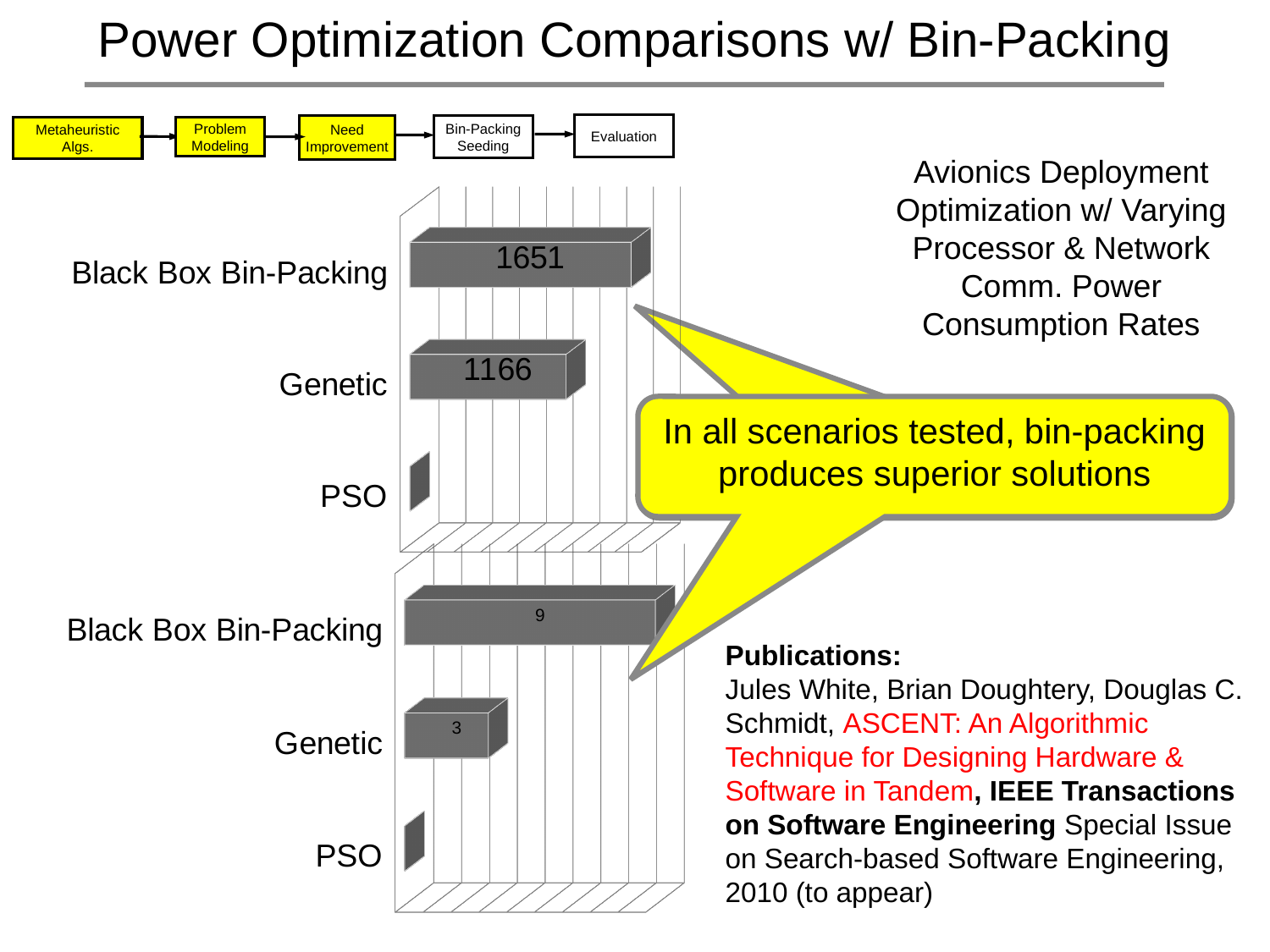
In the top chart, what is the difference between the Black Box Bin-Packing and Genetic values? 485 What kind of chart is the bottom chart? Bar chart In the bottom chart, what is the value for Genetic? 3 In the top chart, which category has the lowest value? PSO In the top chart, what is the value for Black Box Bin-Packing? 1651 In the bottom chart, which is larger, Black Box Bin-Packing or Genetic? Black Box Bin-Packing How many categories does the top chart show? 3 In the bottom chart, which category has the lowest value? PSO In the bottom chart, what is the difference between the Black Box Bin-Packing and Genetic values? 6 In the top chart, what is the value for Genetic? 1166 In the bottom chart, what is the value for Black Box Bin-Packing? 9 In the top chart, which category has the highest value? Black Box Bin-Packing